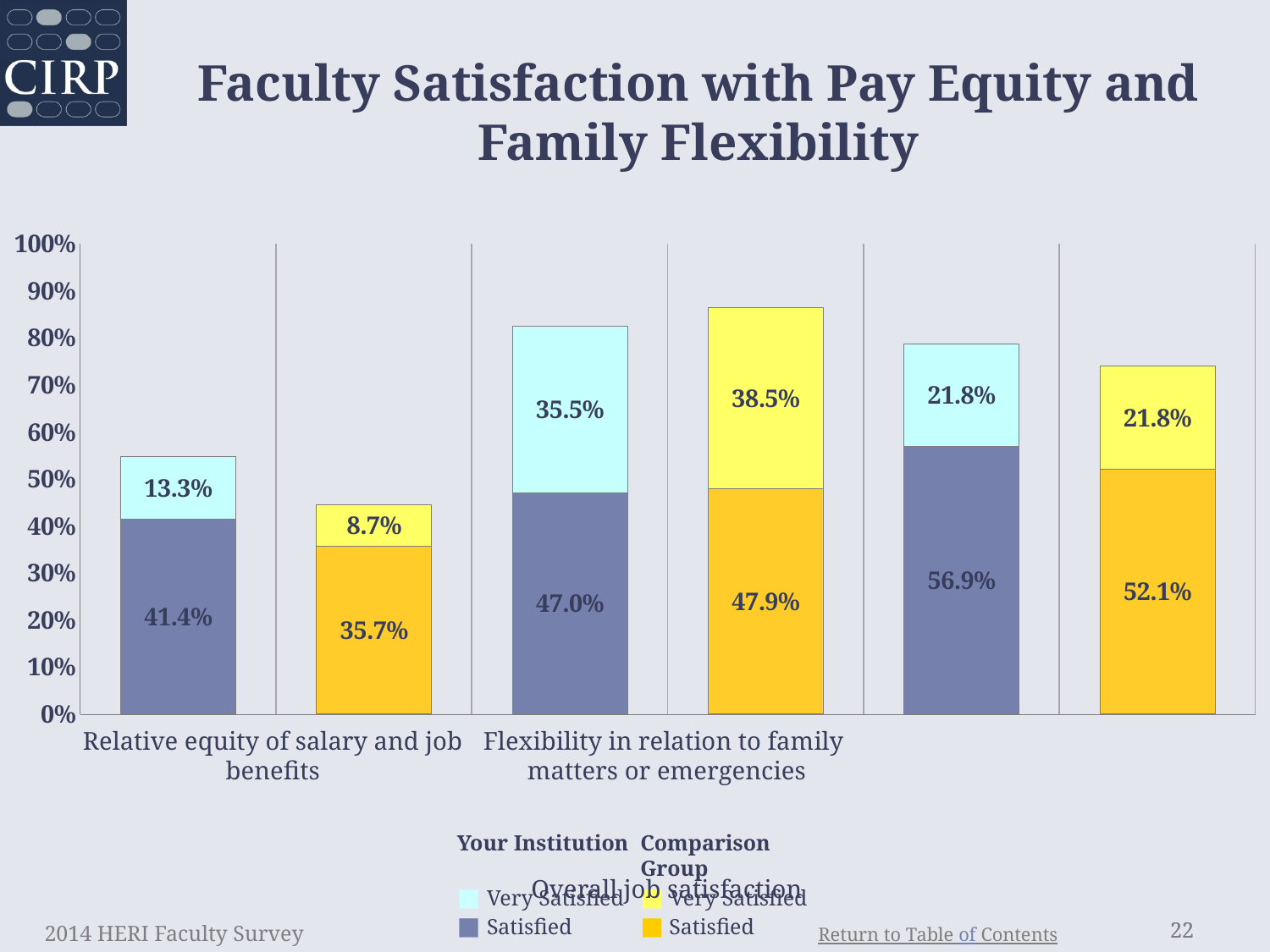
What is the total percentage (Satisfied plus Very Satisfied) for Your Institution on flexibility in relation to family matters or emergencies? 82.5% What percentage of Your Institution faculty are Satisfied with relative equity of salary and job benefits? 41.4% Which group has the larger Very Satisfied percentage for flexibility in relation to family matters or emergencies, Your Institution or the Comparison Group? Comparison Group What percentage of the Comparison Group faculty are Satisfied with flexibility in relation to family matters or emergencies? 47.9% What kind of chart is shown on the slide? Stacked bar chart How many categories are shown on the x axis of the chart? 3 For which category is the Satisfied percentage for Your Institution the highest? Overall job satisfaction What percentage of the Comparison Group faculty are Very Satisfied with relative equity of salary and job benefits? 8.7% What percentage of Your Institution faculty are Very Satisfied with overall job satisfaction? 21.8% What is the total percentage (Satisfied plus Very Satisfied) for the Comparison Group on relative equity of salary and job benefits? 44.4% What is the difference between the Satisfied percentages for Your Institution and the Comparison Group on overall job satisfaction? 4.8% How many entries does the chart legend list? 4